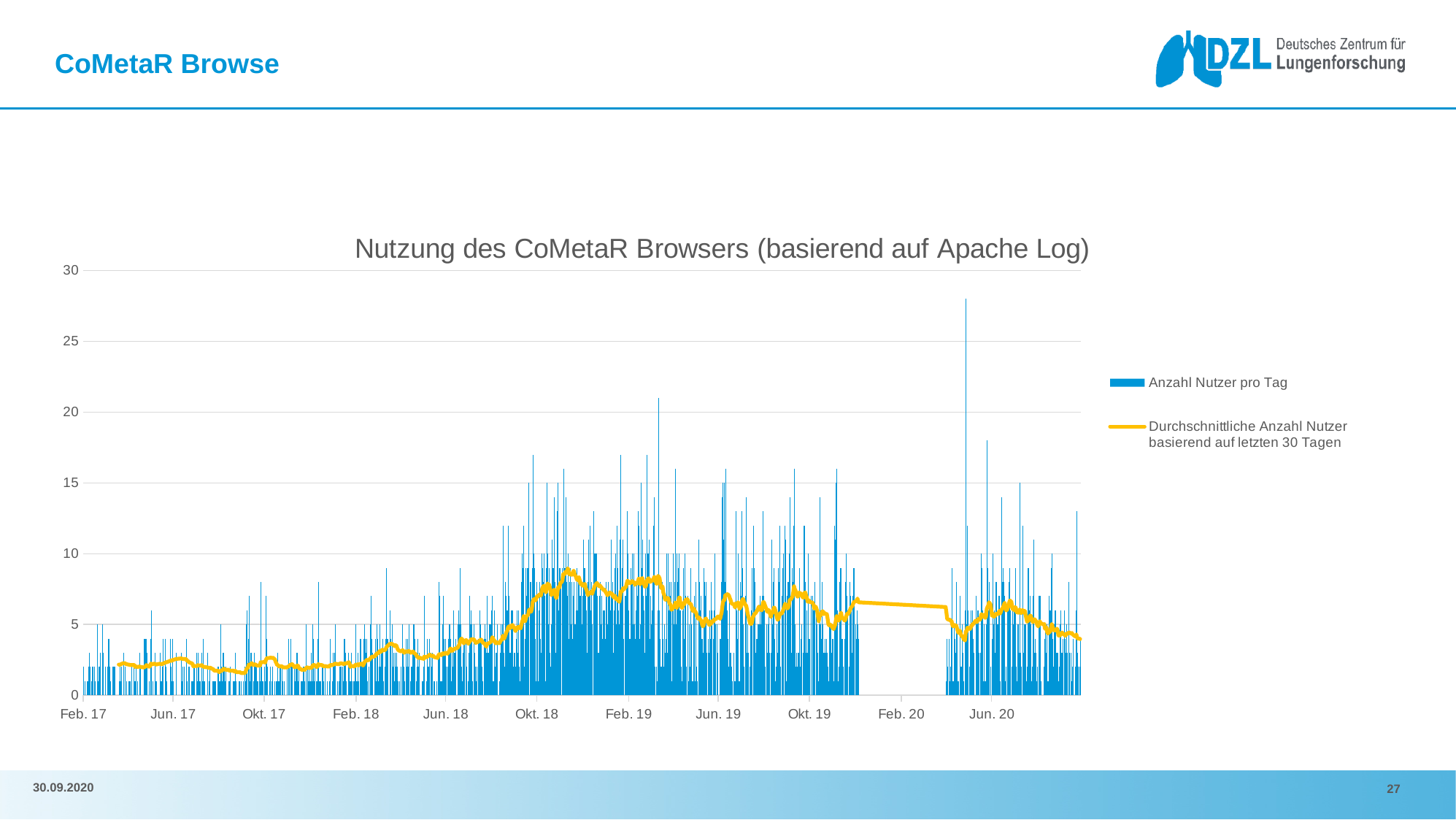
Is the 30-day average number of users higher around Okt. 18 or around Feb. 17? around Okt. 18 Does the 30-day average number of users ever exceed 10 on the chart? No What is the highest value shown on the vertical axis? 30 Around which x-axis label is there a gap with no daily user bars? Feb. 20 Which series is drawn as a yellow line? Durchschnittliche Anzahl Nutzer basierend auf letzten 30 Tagen Is the 30-day average number of users around Okt. 18 greater or less than 5? greater How many series does the chart legend list? 2 Is the 30-day average number of users at Feb. 17 greater or less than 5? less What kind of chart is used to show 'Anzahl Nutzer pro Tag'? bar chart Does the 30-day average number of users rise or fall between Feb. 17 and Okt. 18? rise